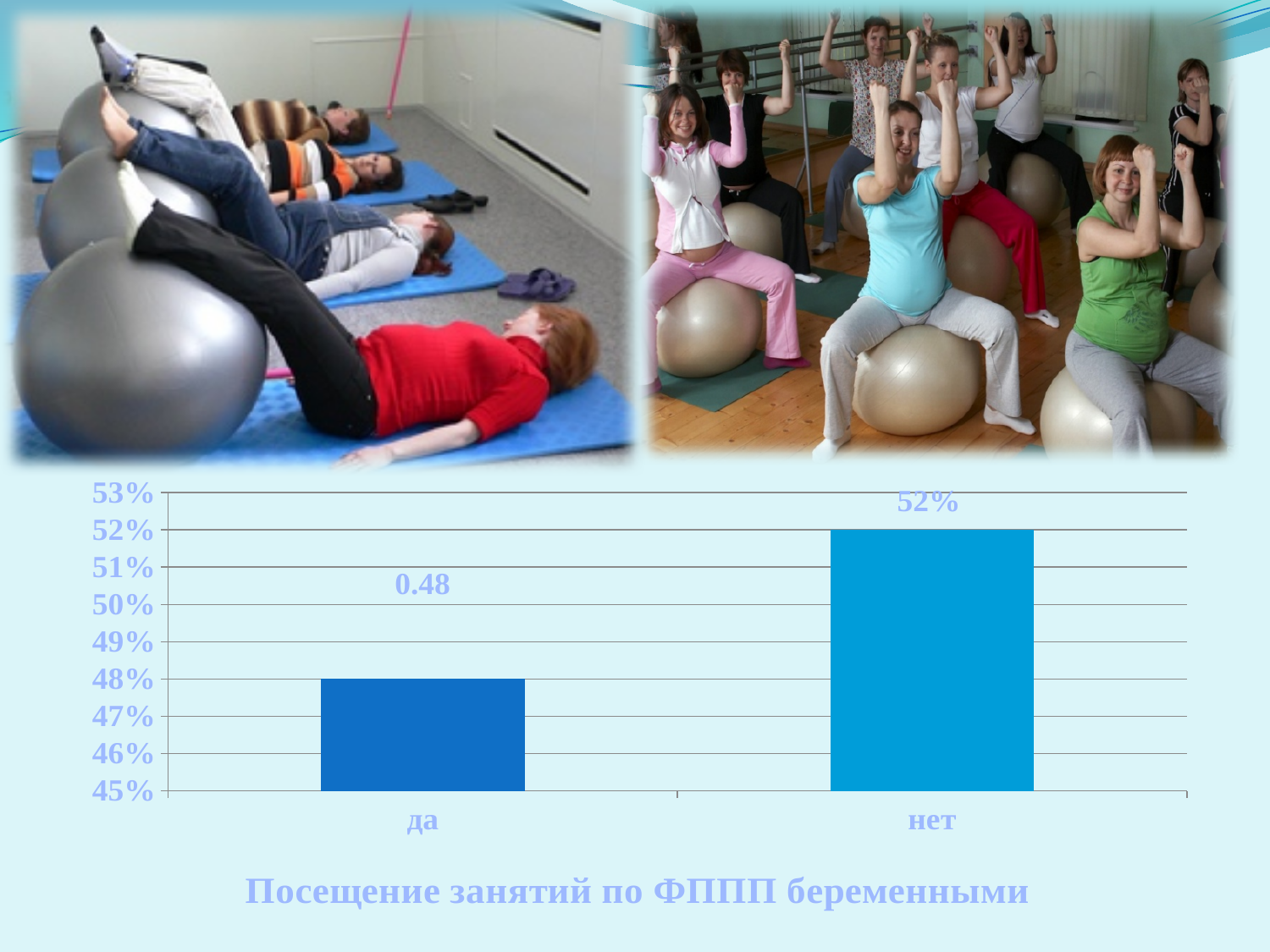
What value is shown for the category "да"? 0.48 What is the lowest value shown on the y axis? 45% What is the title of the chart? Посещение занятий по ФППП беременными Which category has the highest value? нет What value is shown for the category "нет"? 52% Is the value for "нет" greater or less than 50%? greater Which is larger, the value for "да" or the value for "нет"? нет How many categories are shown on the x axis? 2 Is the value for "да" greater or less than 50%? less Which category has the lowest value? да What is the difference between the value for "нет" and the value for "да"? 4% What kind of chart is shown on the slide? bar chart